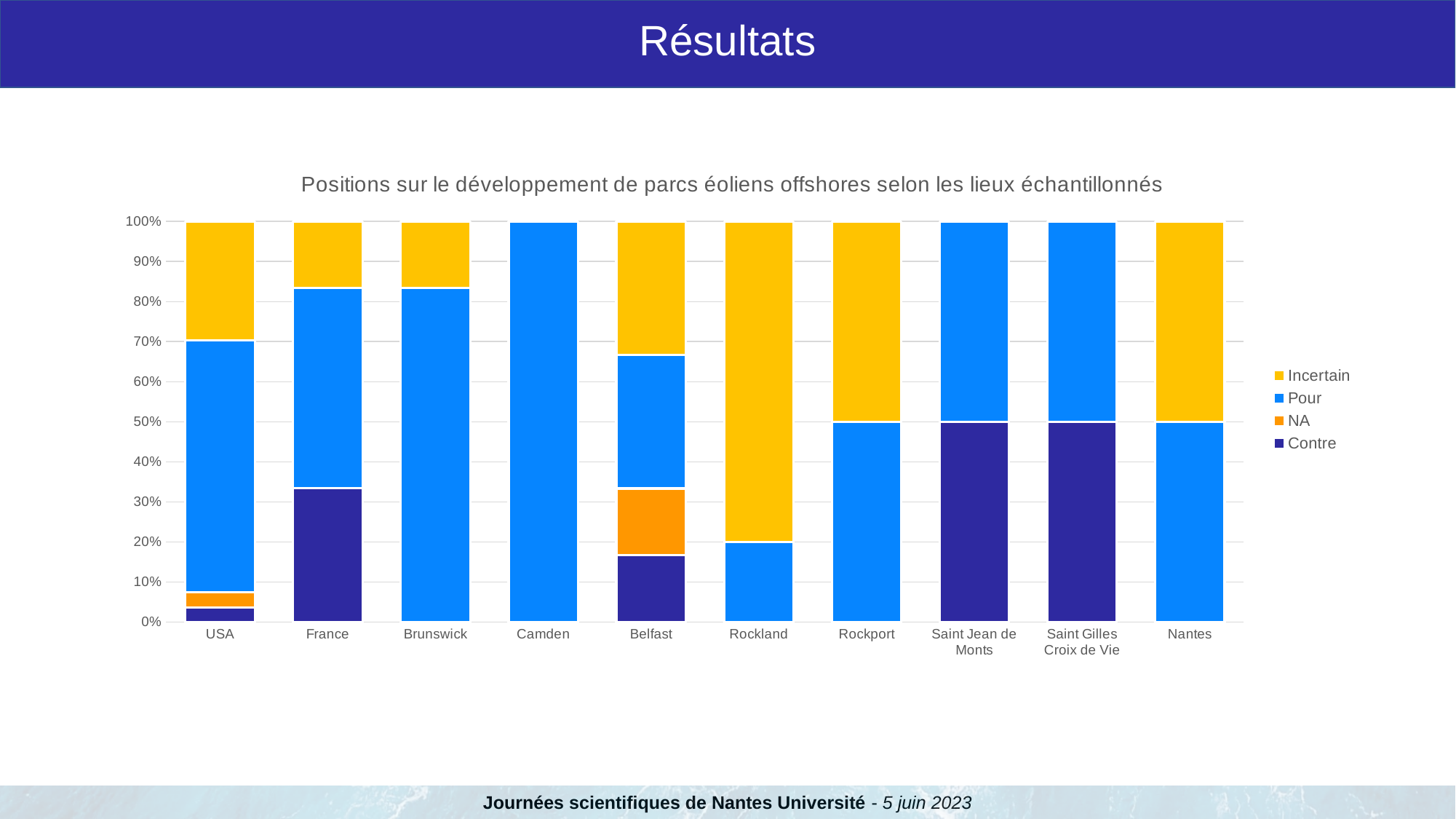
Which location has the smallest Pour share? Rockland What is the Pour share for Camden? 100% How many locations are shown on the x axis of the chart? 10 Is the Pour share larger for USA or for Belfast? USA What kind of chart is shown on the slide? Stacked bar chart Is the Pour share for USA greater or less than 60%? greater What is the Pour share for Rockport? 50% Which location has the largest Incertain share? Rockland What is the title of the chart? Positions sur le développement de parcs éoliens offshores selon les lieux échantillonnés Which series is shown in dark blue in the chart? Contre How many series does the chart legend list? 4 Which location has the largest Pour share? Camden